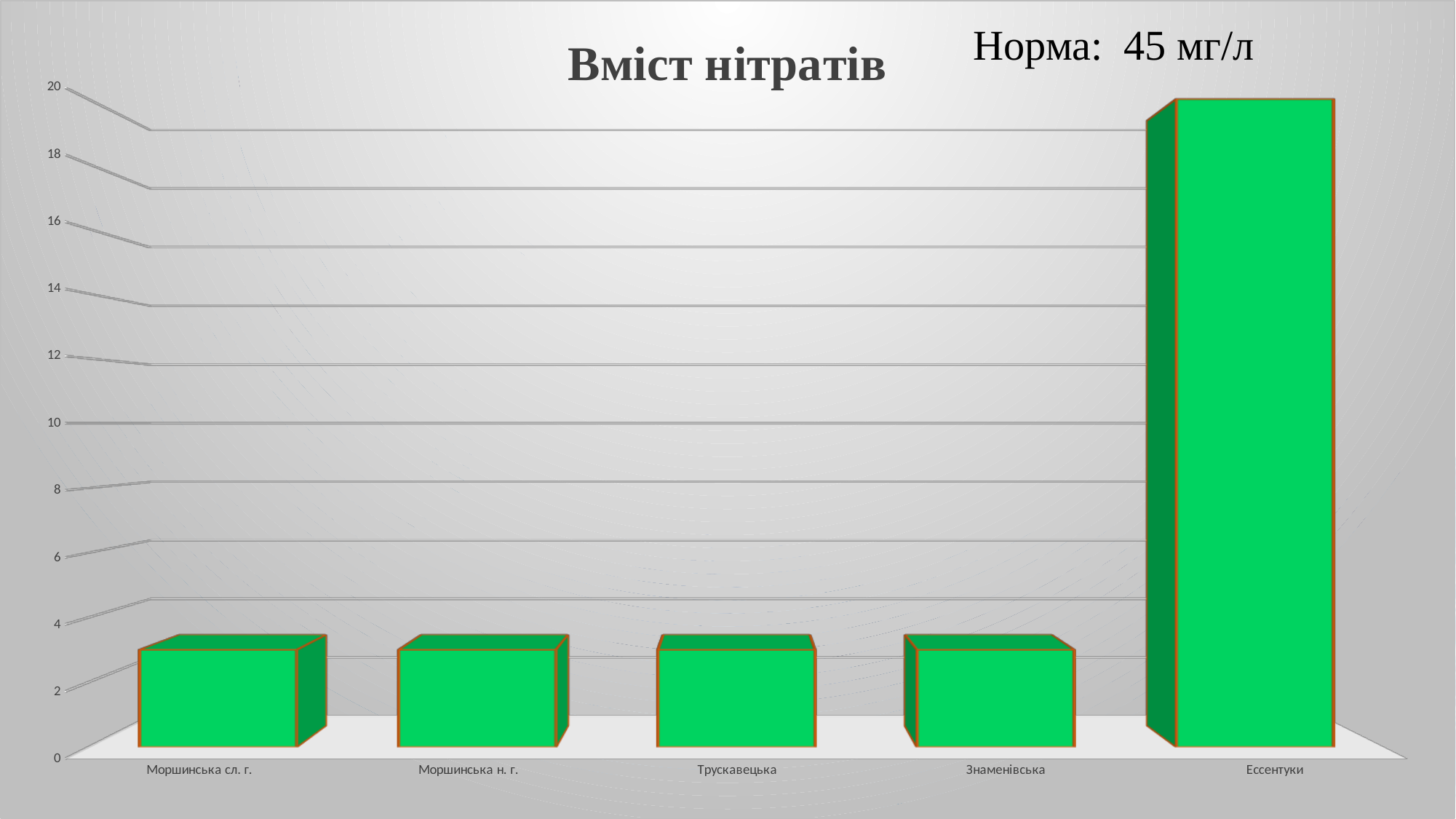
Which is larger, the value for Ессентуки or the value for Знаменівська? Ессентуки What kind of chart is shown on the slide? bar chart Is the value for Ессентуки greater or less than 16? greater How many categories are shown on the x axis of the chart? 5 What is the title of the chart? Вміст нітратів Is the value for Моршинська сл. г. greater or less than 8? less Is the value for Трускавецька greater or less than 6? less What is the highest tick value shown on the vertical axis? 20 What norm value is stated in the text next to the chart title? 45 мг/л Which category has the highest value in the chart? Ессентуки